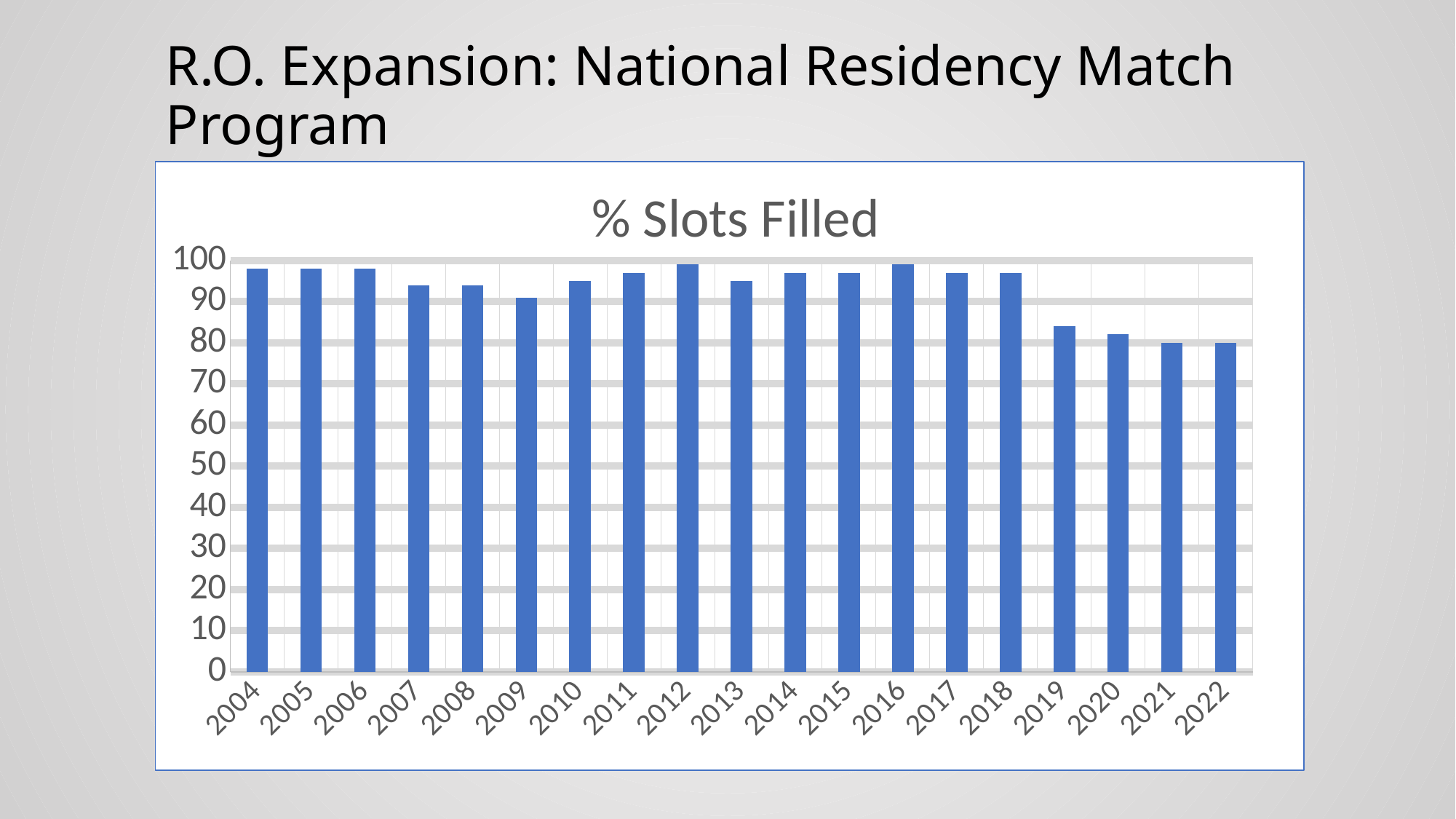
Do the values rise or fall from 2018 to 2022? fall Is the value for 2004 greater or less than 90? greater What is the first year shown on the x axis? 2004 Is the value for 2007 greater or less than 90? greater How many years are shown on the x axis of the chart? 19 What kind of chart is shown on the slide? bar chart Is the value for 2019 greater or less than 80? greater What is the title of the chart? % Slots Filled Which year has the larger value, 2012 or 2019? 2012 Which year has the larger value, 2018 or 2019? 2018 Which year has the larger value, 2004 or 2022? 2004